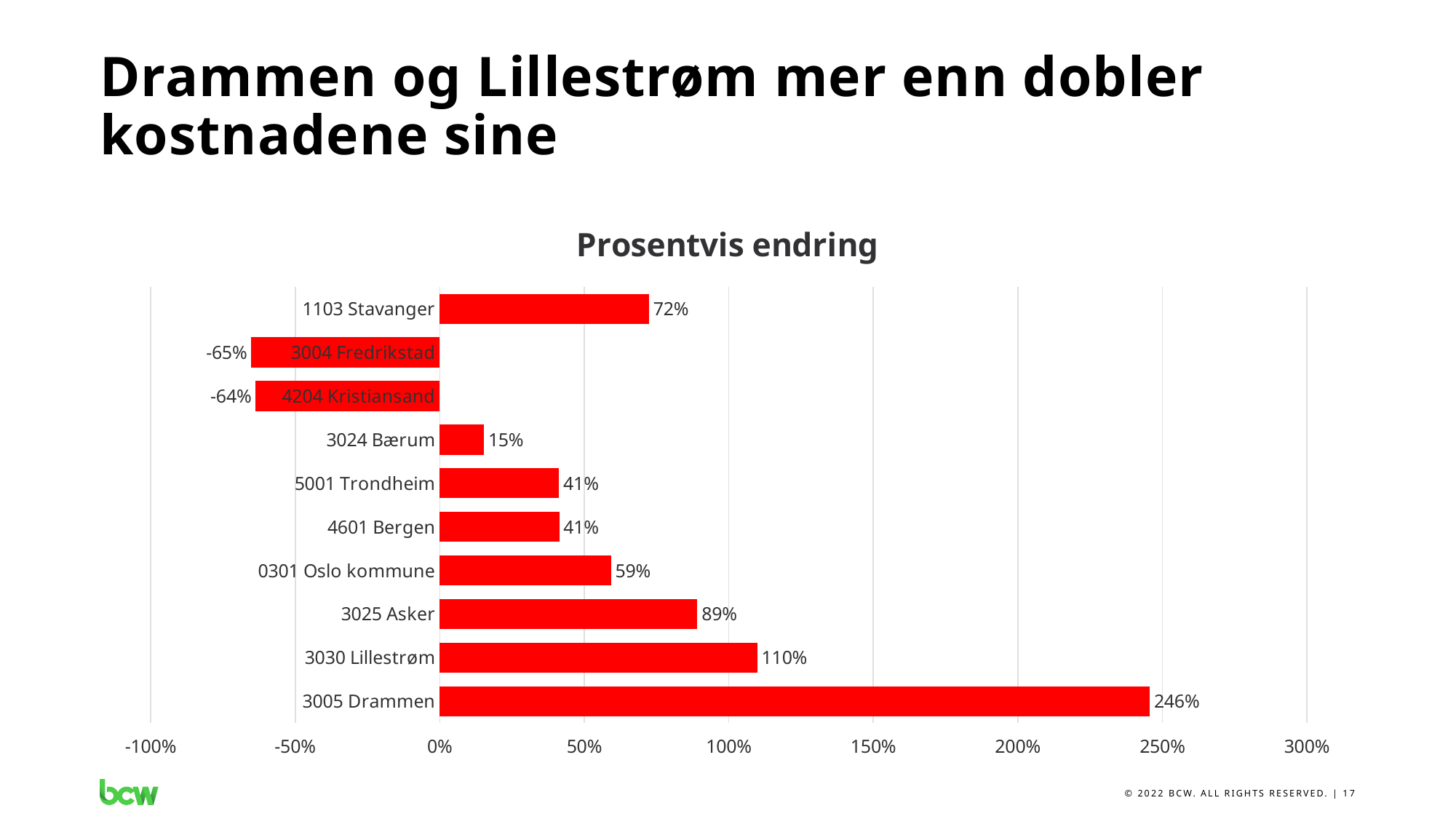
What is the difference between the values for 3005 Drammen and 3030 Lillestrøm? 136% Is the value for 1103 Stavanger greater or less than 50%? greater What is the value for 3030 Lillestrøm? 110% What is the value for 3005 Drammen? 246% What colour are the bars in the chart? red Which category has the lowest value? 3004 Fredrikstad Which is larger, the value for 3025 Asker or the value for 0301 Oslo kommune? 3025 Asker How many categories are shown in the chart? 10 What is the title of the chart? Prosentvis endring Which category has the highest value? 3005 Drammen What kind of chart is shown on the slide? bar chart What is the value for 3004 Fredrikstad? -65%